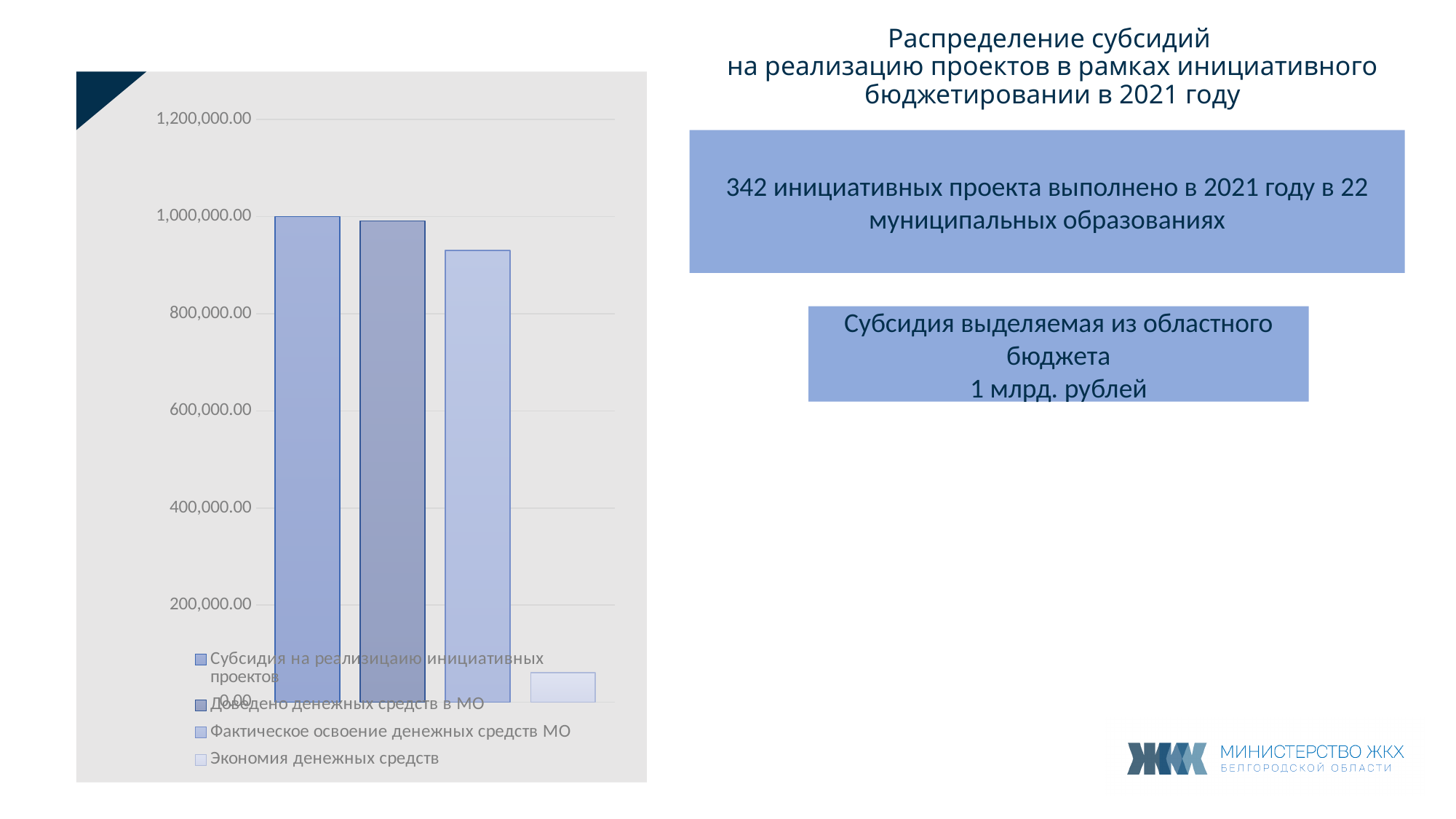
Which is larger: the value for Доведено денежных средств в МО or the value for Фактическое освоение денежных средств МО? Доведено денежных средств в МО Which legend entry is shown with the lightest colour in the chart? Экономия денежных средств Which is larger: the value for Фактическое освоение денежных средств МО or the value for Экономия денежных средств? Фактическое освоение денежных средств МО Which series has the lowest bar in the chart? Экономия денежных средств Do the bar values rise or fall from left to right across the chart? fall How many bars are plotted in the chart? 4 Is the value for Доведено денежных средств в МО greater or less than 1,200,000.00? less How many series does the chart legend list? 4 Is the value for Фактическое освоение денежных средств МО greater or less than 800,000.00? greater What kind of chart is shown on the slide? bar chart What is the highest value shown on the chart's vertical axis? 1,200,000.00 Is the value for Экономия денежных средств greater or less than 200,000.00? less